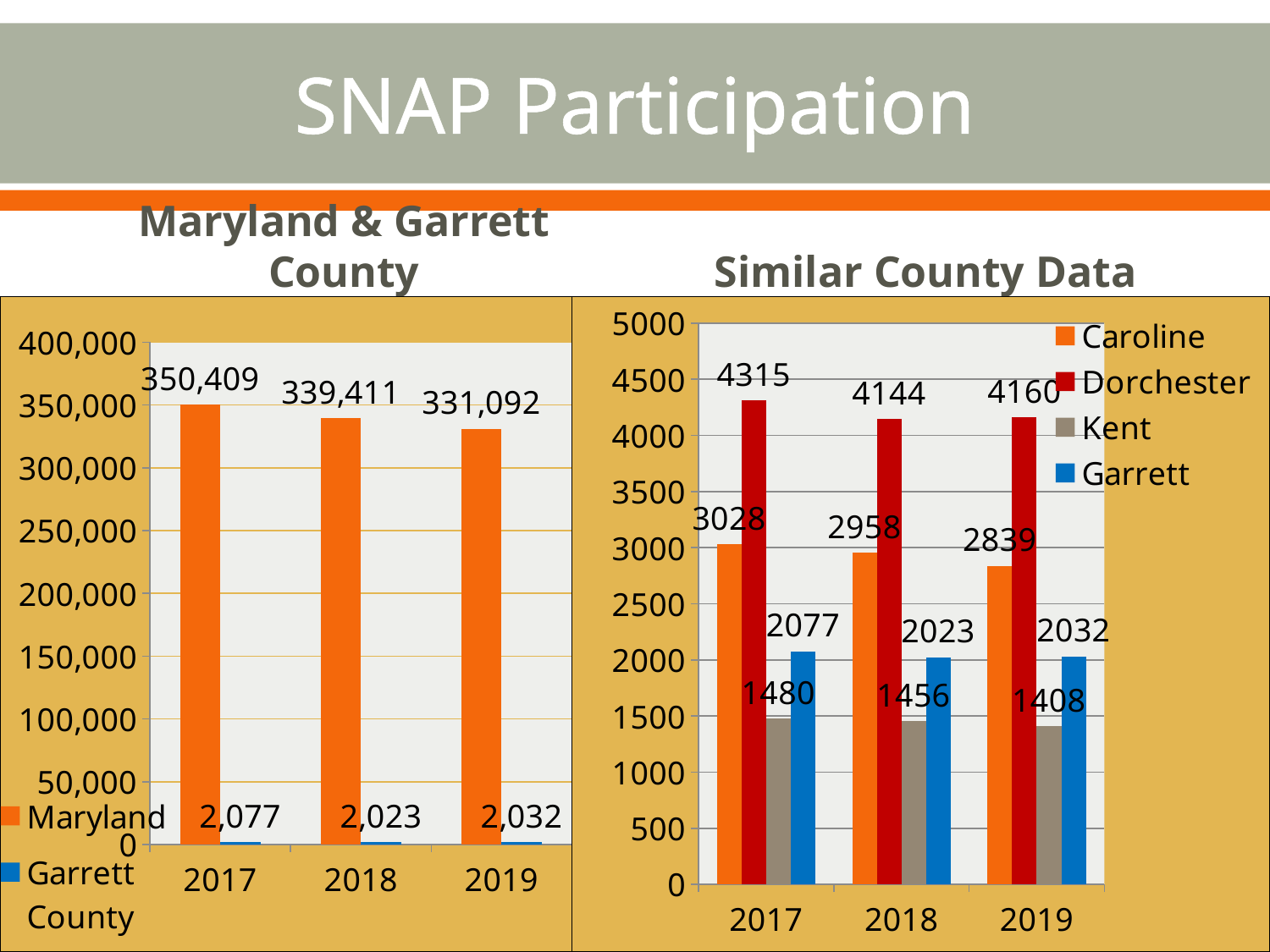
In the 'Similar County Data' chart, what is the value for Dorchester in 2018? 4144 In the 'Similar County Data' chart, which county has the lowest value in 2018? Kent In the 'Similar County Data' chart, which county has the highest value in 2017? Dorchester In the 'Similar County Data' chart, how many series does the legend list? 4 In the 'Similar County Data' chart, what is the value for Kent in 2019? 1408 In the 'Maryland & Garrett County' chart, what is the difference between the Maryland values for 2017 and 2018? 10,998 In the 'Maryland & Garrett County' chart, how many series does the legend list? 2 In the 'Maryland & Garrett County' chart, do the Maryland values rise or fall from 2017 to 2019? fall In the 'Maryland & Garrett County' chart, in which year is the Maryland value lowest? 2019 In the 'Maryland & Garrett County' chart, what is the value for Maryland in 2017? 350,409 In the 'Maryland & Garrett County' chart, what is the value for Garrett County in 2019? 2,032 In the 'Similar County Data' chart, what is the difference between the Caroline values for 2017 and 2019? 189